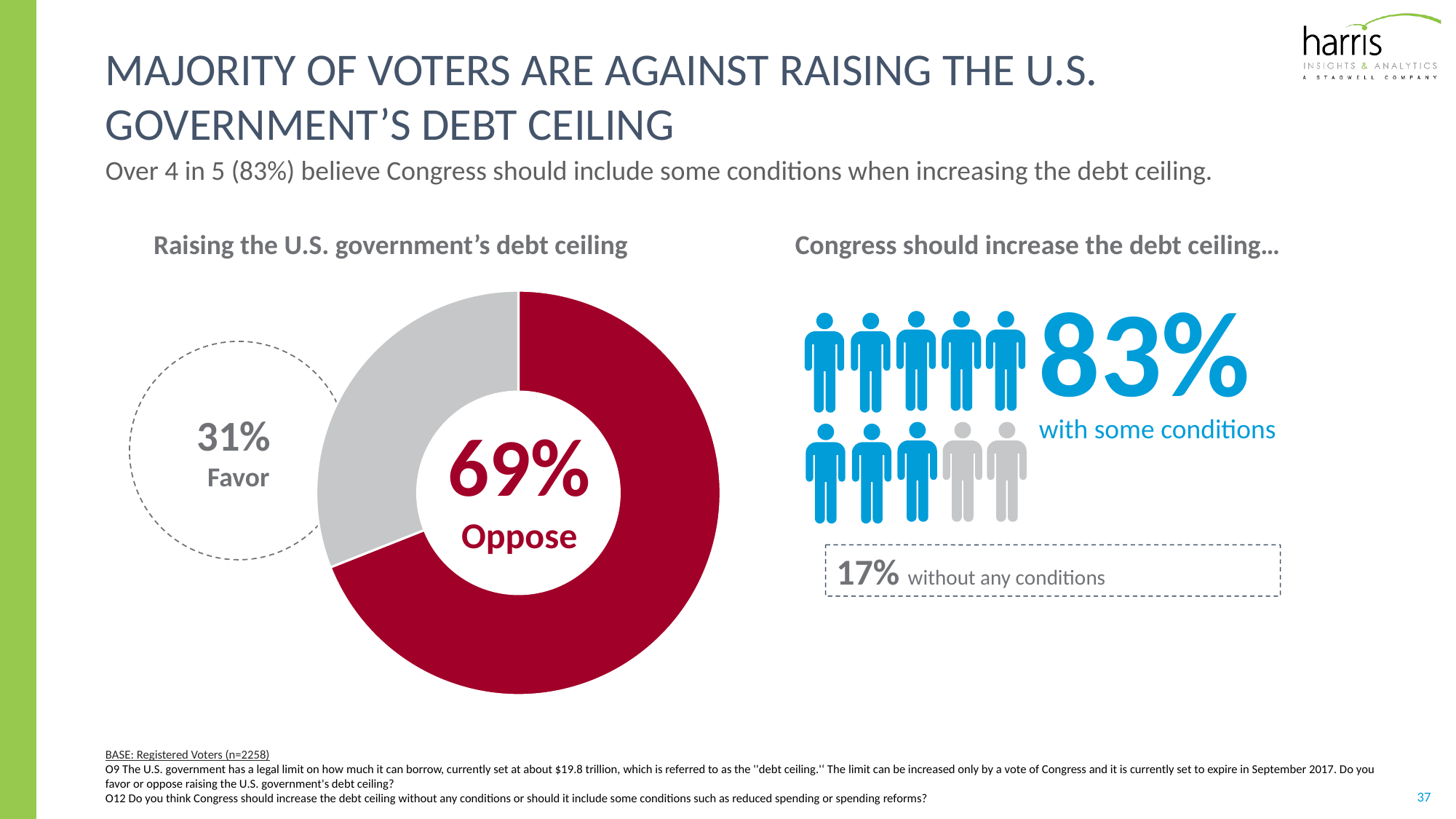
In the chart titled "Raising the U.S. government's debt ceiling", what share of voters favor raising the debt ceiling? 31% In the graphic titled "Congress should increase the debt ceiling...", how many person icons are shown in total? 10 In the chart titled "Raising the U.S. government's debt ceiling", what colour is the Oppose segment? Red In the graphic titled "Congress should increase the debt ceiling...", which option has the smaller share? Without any conditions In the graphic titled "Congress should increase the debt ceiling...", what share of voters say the increase should come with some conditions? 83% In the chart titled "Raising the U.S. government's debt ceiling", how many response categories are shown? 2 What kind of chart is shown under the title "Raising the U.S. government's debt ceiling"? Donut (pie) chart In the chart titled "Raising the U.S. government's debt ceiling", what share of voters oppose raising the debt ceiling? 69% In the graphic titled "Congress should increase the debt ceiling...", what is the difference in percentage points between "with some conditions" and "without any conditions"? 66 percentage points In the chart titled "Raising the U.S. government's debt ceiling", which response has the larger share, Favor or Oppose? Oppose In the chart titled "Raising the U.S. government's debt ceiling", what is the difference in percentage points between Oppose and Favor? 38 percentage points In the graphic titled "Congress should increase the debt ceiling...", what share of voters say the increase should come without any conditions? 17%